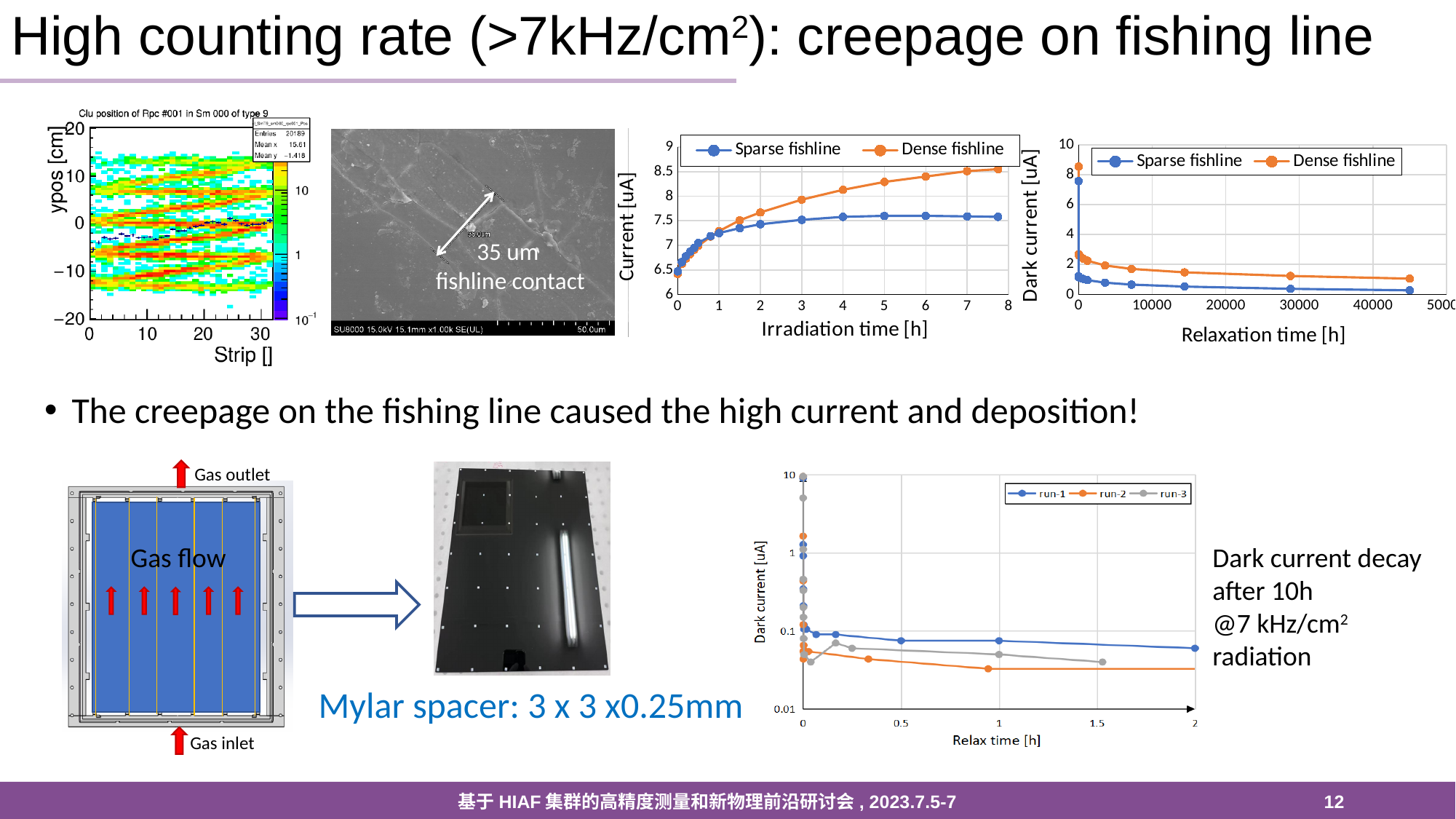
In the chart of Current versus Irradiation time, is the Sparse fishline current at 7 h greater or less than 8 uA? less In the chart of Current versus Irradiation time, does the current rise or fall as irradiation time increases? rise In the bottom chart of Dark current versus Relax time, which run has the highest dark current at 1 h? run-1 In the chart of Dark current versus Relaxation time, does the dark current rise or fall as relaxation time increases? fall In the bottom chart of Dark current versus Relax time, how many series does the legend list? 3 In the chart of Dark current versus Relaxation time, is the Dense fishline dark current at 40000 h greater or less than 2 uA? less In the chart of Current versus Irradiation time, how many series does the legend list? 2 In the chart of Current versus Irradiation time, is the Dense fishline current at 7 h greater or less than 8 uA? greater In the chart of Dark current versus Relaxation time, how many series does the legend list? 2 In the chart of Dark current versus Relaxation time, which series has the higher dark current at 40000 h, Sparse fishline or Dense fishline? Dense fishline In the chart of Current versus Irradiation time, what kind of chart is it? line chart In the chart of Current versus Irradiation time, which series has the higher current at 7 h, Sparse fishline or Dense fishline? Dense fishline